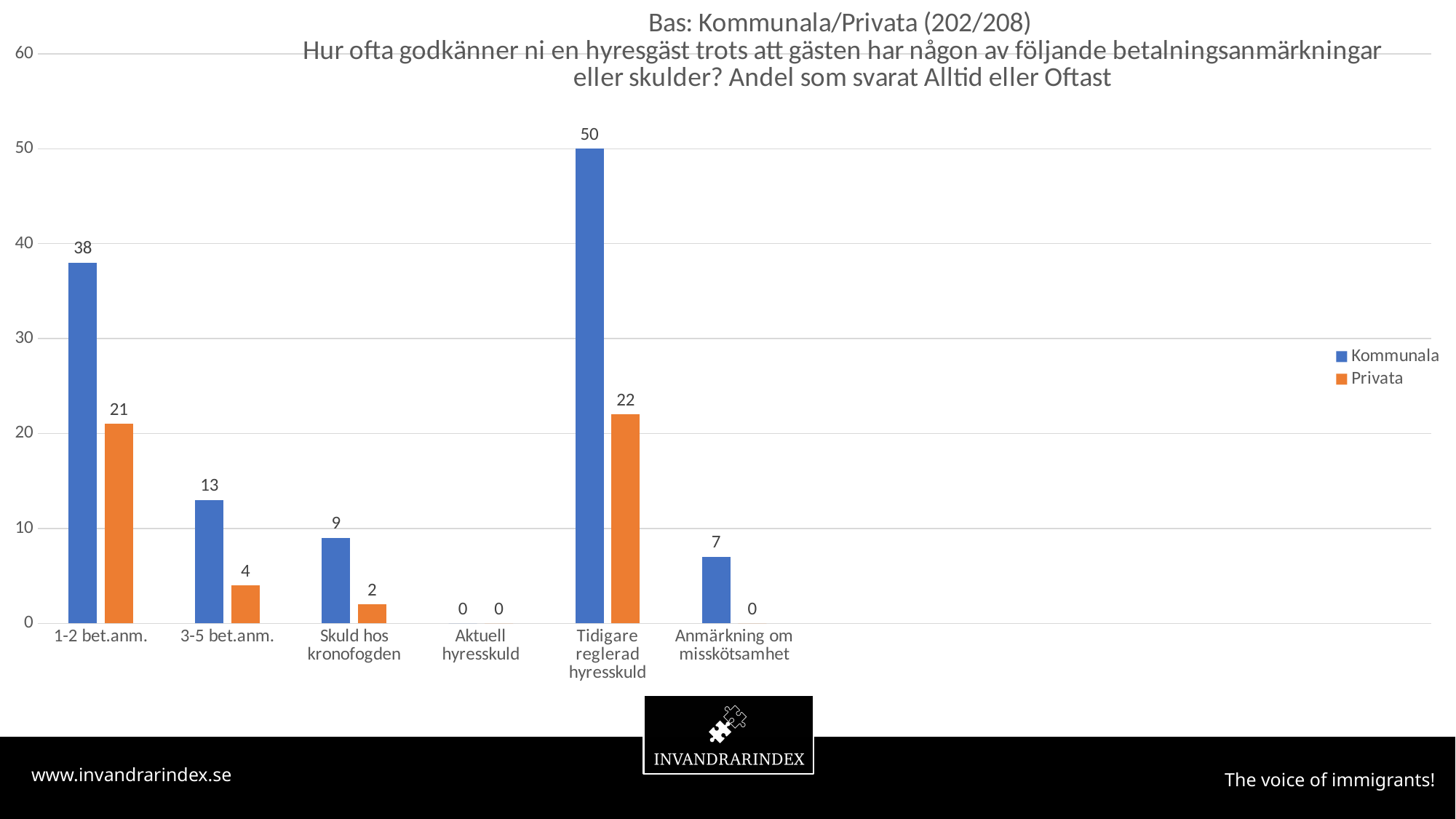
How many categories are shown on the x axis? 6 What kind of chart is shown on the slide? Bar chart Which category has the highest Kommunala value? Tidigare reglerad hyresskuld What is the Privata value for 'Tidigare reglerad hyresskuld'? 22 What is the Kommunala value for 'Anmärkning om misskötsamhet'? 7 What is the Kommunala value for '1-2 bet.anm.'? 38 What is the difference between the Kommunala and Privata values for '1-2 bet.anm.'? 17 Which category has the lowest Kommunala value? Aktuell hyresskuld What is the Privata value for 'Skuld hos kronofogden'? 2 Which colour represents the Privata series in the legend? Orange How many series does the legend list? 2 Which is larger for '3-5 bet.anm.': the Kommunala value or the Privata value? Kommunala